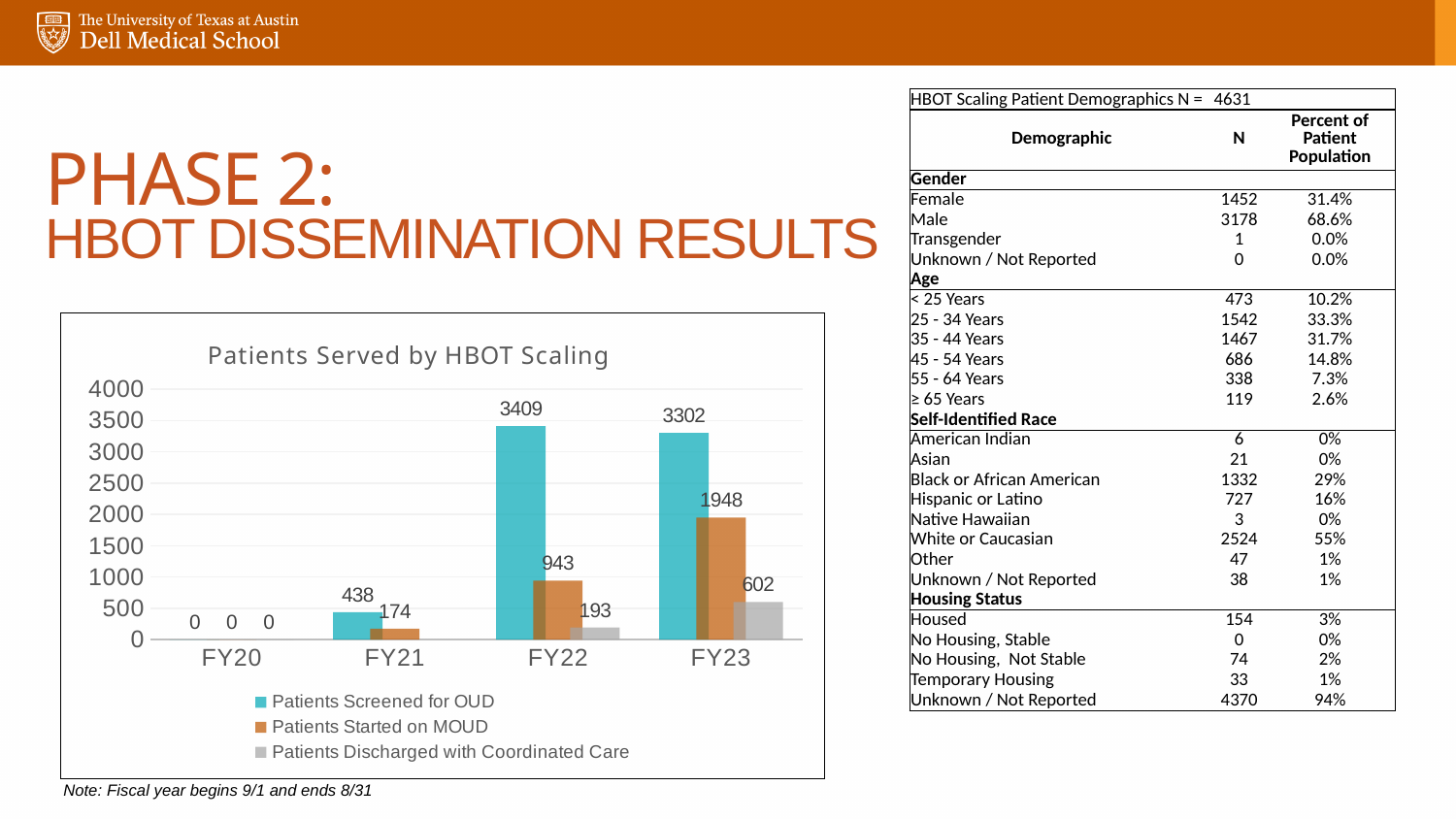
What is the value for Patients Started on MOUD in FY23? 1948 In which fiscal year is the number of Patients Screened for OUD highest? FY22 Which is larger: Patients Started on MOUD in FY22 or in FY23? FY23 How many series does the legend list? 3 In which fiscal year is the number of Patients Started on MOUD lowest? FY20 What is the title of the chart? Patients Served by HBOT Scaling What is the difference between Patients Screened for OUD in FY22 and FY23? 107 What is the value for Patients Discharged with Coordinated Care in FY22? 193 What kind of chart is shown? Bar chart What is the value for Patients Started on MOUD in FY21? 174 What is the value for Patients Screened for OUD in FY22? 3409 How many fiscal years are shown on the x axis? 4